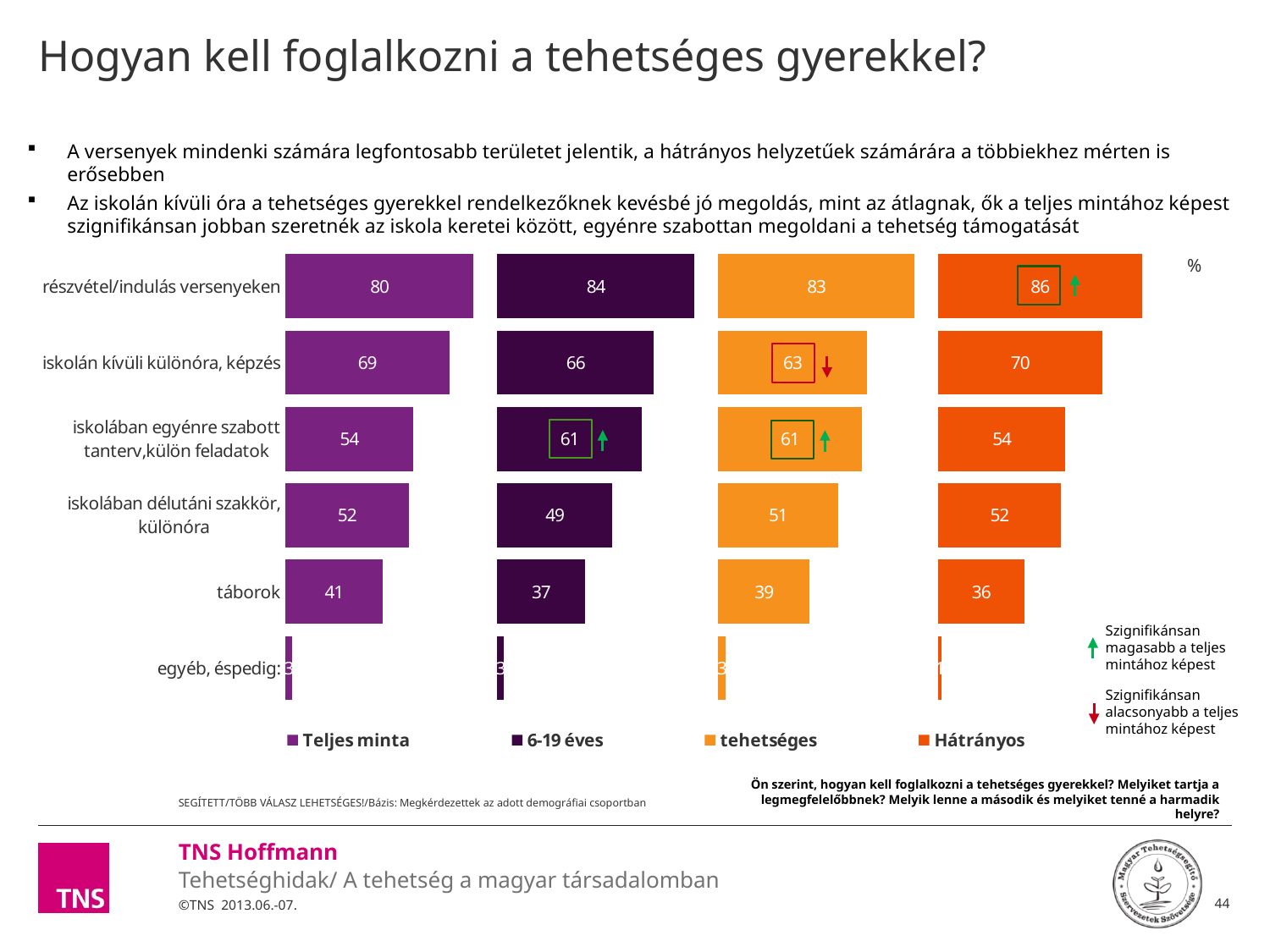
What does the green upward arrow next to a bar indicate, according to the legend? Szignifikánsan magasabb a teljes mintához képest What is the value for "iskolán kívüli különóra, képzés" in the "tehetséges" series? 63 What is the value for "iskolában egyénre szabott tanterv,külön feladatok" in the "6-19 éves" series? 61 Which series has the lowest value for "táborok"? Hátrányos What is the difference between the "Hátrányos" and "Teljes minta" values for "részvétel/indulás versenyeken"? 6 What kind of chart is shown on the slide? bar chart Which category has the highest value in the "6-19 éves" series? részvétel/indulás versenyeken How many series does the legend list? 4 How many categories are shown on the chart? 6 What is the value for "táborok" in the "Hátrányos" series? 36 What is the value for "részvétel/indulás versenyeken" in the "Teljes minta" series? 80 Which is larger for "iskolán kívüli különóra, képzés": the "Teljes minta" value or the "6-19 éves" value? Teljes minta